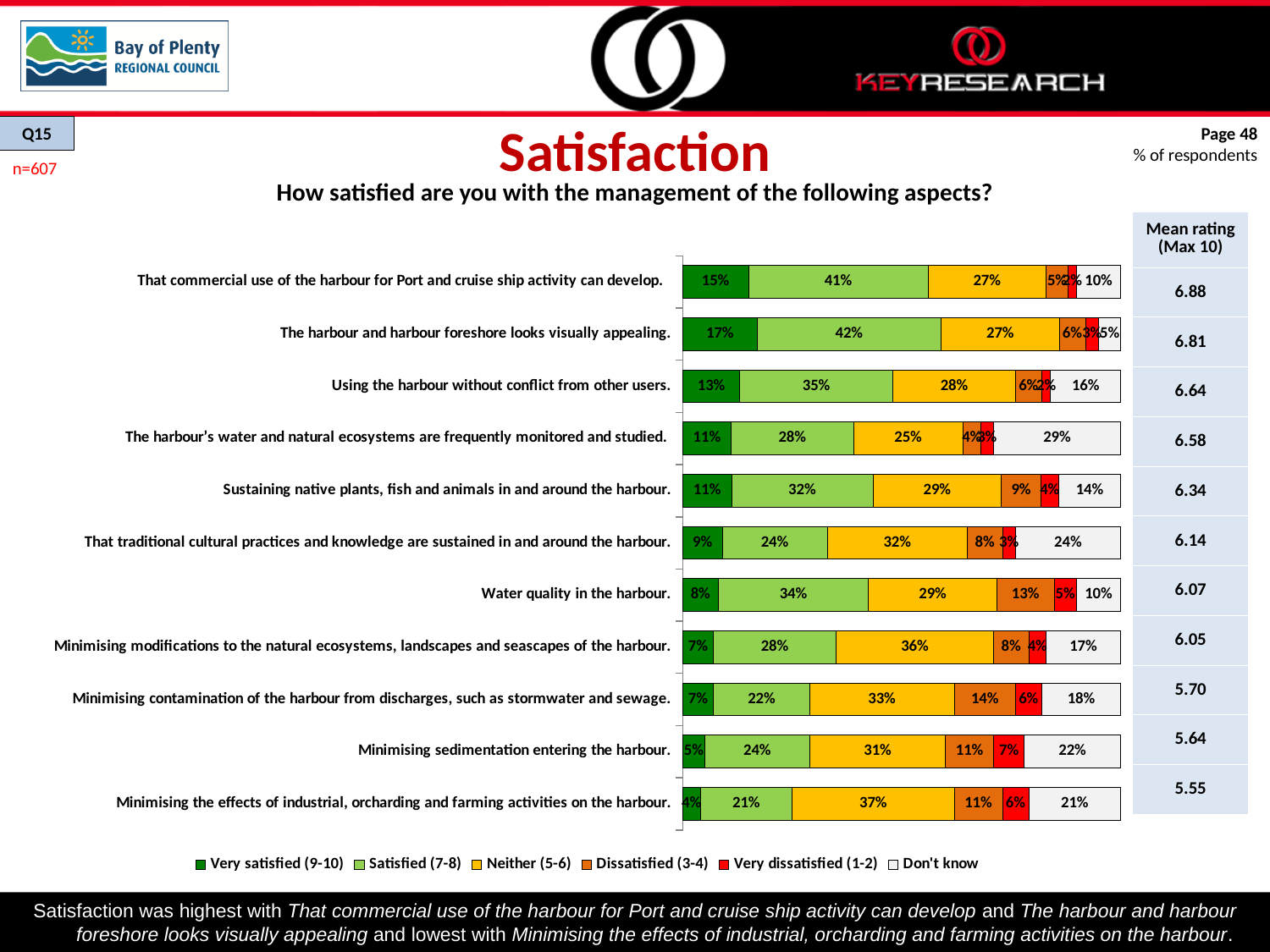
Which aspect has the highest Very satisfied (9-10) value? The harbour and harbour foreshore looks visually appealing Which is larger: the Don't know value for 'Minimising sedimentation entering the harbour' or for 'Using the harbour without conflict from other users'? Minimising sedimentation entering the harbour Which legend entry is shown in red? Very dissatisfied (1-2) What is the Dissatisfied (3-4) value for 'Minimising contamination of the harbour from discharges, such as stormwater and sewage'? 14% What is the Satisfied (7-8) value for 'The harbour and harbour foreshore looks visually appealing'? 42% What kind of chart is shown on the slide? Stacked bar chart What is the Don't know value for 'The harbour's water and natural ecosystems are frequently monitored and studied'? 29% Which aspect has the lowest Very satisfied (9-10) value? Minimising the effects of industrial, orcharding and farming activities on the harbour What is the Neither (5-6) value for 'Minimising the effects of industrial, orcharding and farming activities on the harbour'? 37% What is the difference between the Satisfied (7-8) values for 'That commercial use of the harbour for Port and cruise ship activity can develop' and 'Water quality in the harbour'? 7% How many aspects (categories) are plotted in the chart? 11 How many series does the chart legend list? 6